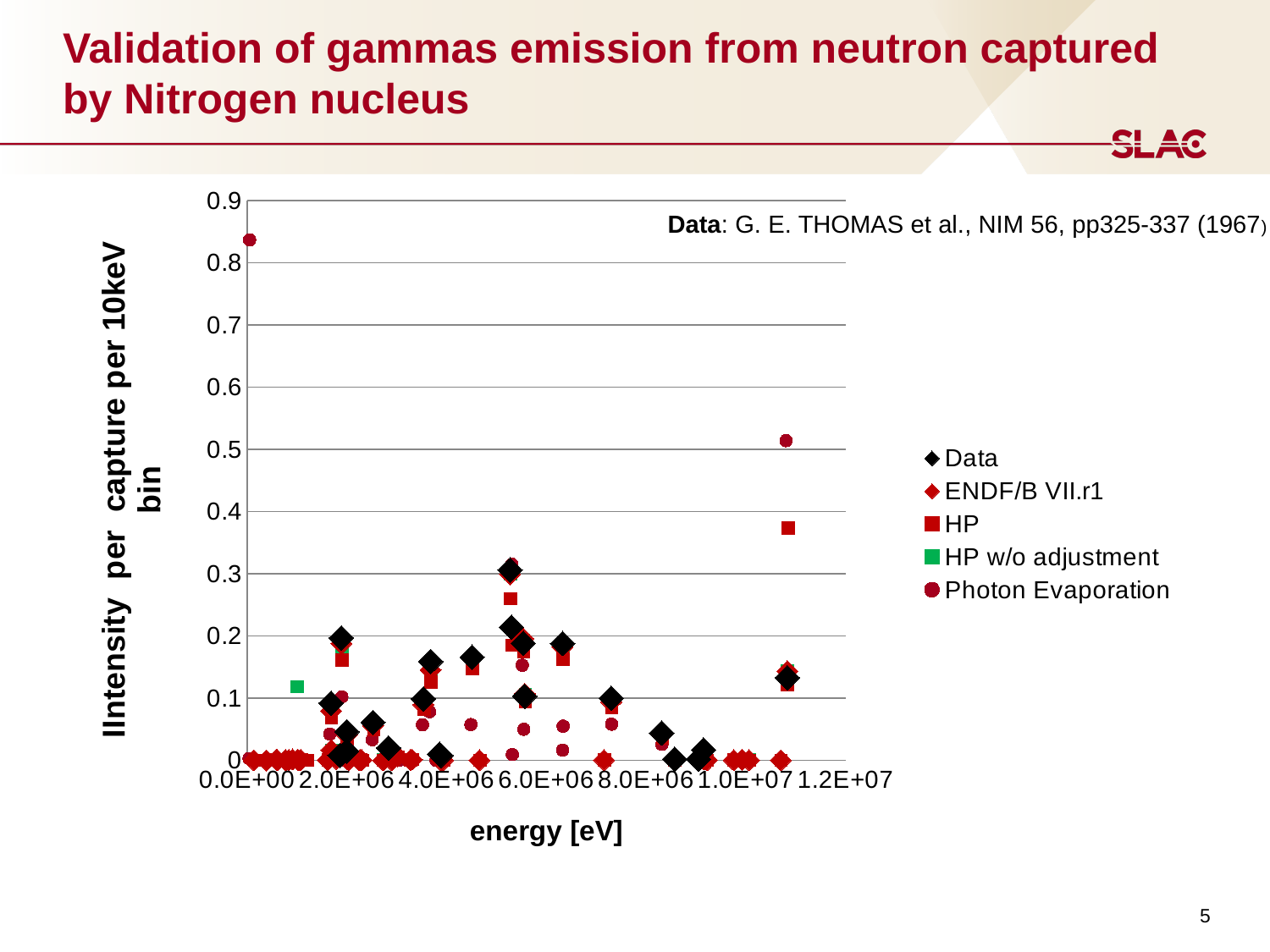
Is the highest Data point (near 5.5E+06 eV) greater or less than 0.2? greater Which series has the highest plotted point on the chart? Photon Evaporation What is the x-axis title of the chart? energy [eV] Is the HP w/o adjustment point greater or less than 0.2? less Is the Photon Evaporation point near 1.1E+07 eV greater or less than 0.4? greater What kind of chart is shown on the slide? scatter chart How many series does the legend list? 5 Which series does the legend list with a green square marker? HP w/o adjustment